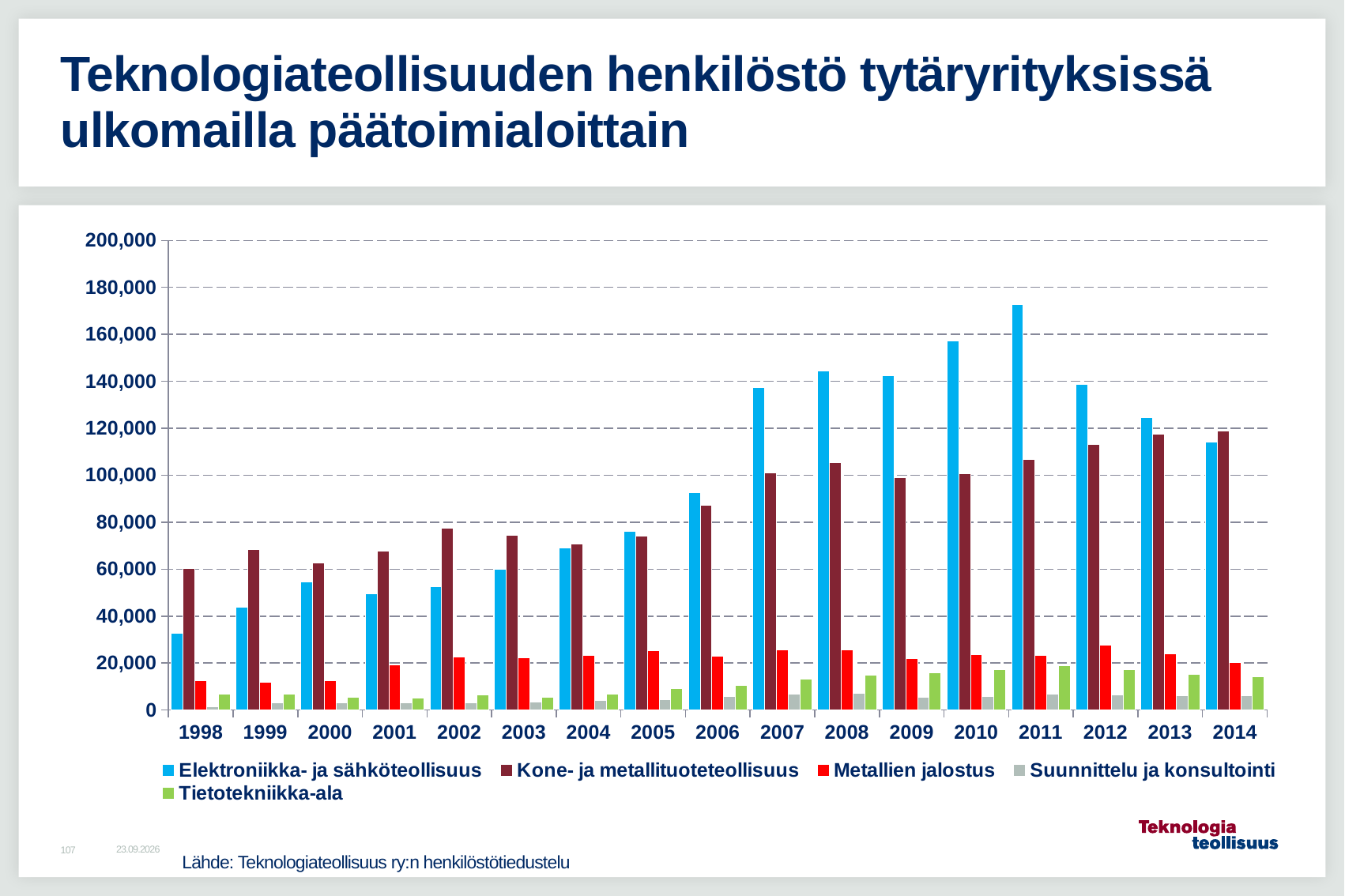
In 2002, which is larger: Elektroniikka- ja sähköteollisuus or Kone- ja metallituoteteollisuus? Kone- ja metallituoteteollisuus Is the value for Elektroniikka- ja sähköteollisuus in 2011 greater or less than 160,000? greater In which year is the value for Elektroniikka- ja sähköteollisuus lowest? 1998 In 2010, which is larger: Elektroniikka- ja sähköteollisuus or Kone- ja metallituoteteollisuus? Elektroniikka- ja sähköteollisuus Is the value for Kone- ja metallituoteteollisuus in 2014 greater or less than 100,000? greater In which year is the value for Elektroniikka- ja sähköteollisuus highest? 2011 Does the value for Elektroniikka- ja sähköteollisuus rise or fall from 1998 to 2007? rise How many years are shown on the x axis? 17 Which colour represents Tietotekniikka-ala in the legend? Green How many series does the legend list? 5 What kind of chart is shown on the slide? Bar chart Is the value for Metallien jalostus in 1998 greater or less than 20,000? less